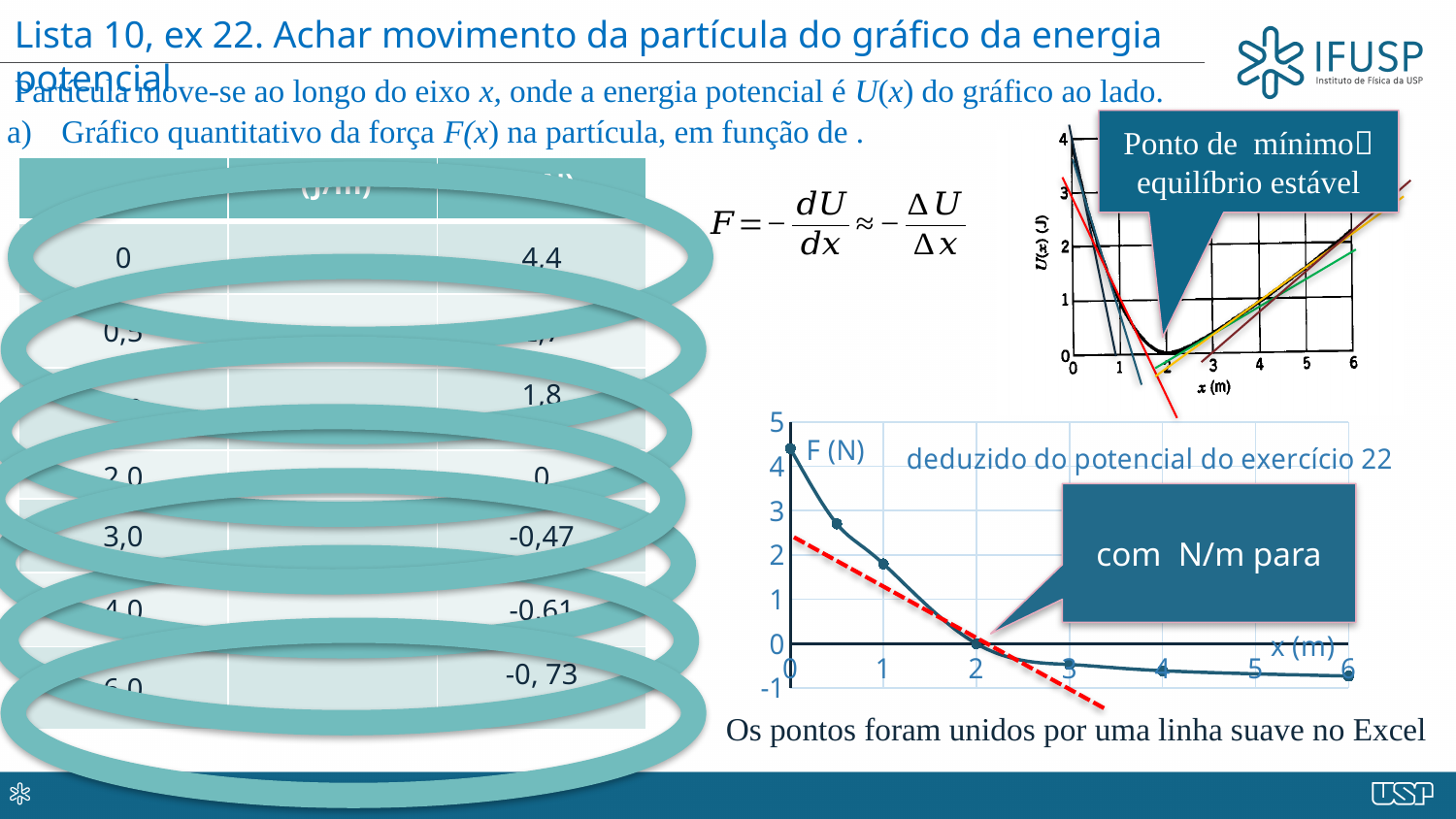
On the F (N) versus x (m) chart, is the value of F at x = 0 greater or less than 4? greater On the F (N) versus x (m) chart, what kind of chart is it? line chart On the F (N) versus x (m) chart, which is larger, F at x = 0 or F at x = 1? F at x = 0 On the F (N) versus x (m) chart, is the value of F at x = 6 greater or less than 0? less On the F (N) versus x (m) chart, is the value of F at x = 1 greater or less than 1? greater On the F (N) versus x (m) chart, do the values rise or fall as x increases? fall On the F (N) versus x (m) chart, what is the label on the vertical axis? F (N) On the F (N) versus x (m) chart, how many data points are plotted? 7 On the F (N) versus x (m) chart, at which x value is F highest? 0 On the U(x) graph in the upper right, what is the label on the horizontal axis? x (m) On the F (N) versus x (m) chart, what is the value of F at x = 2? 0